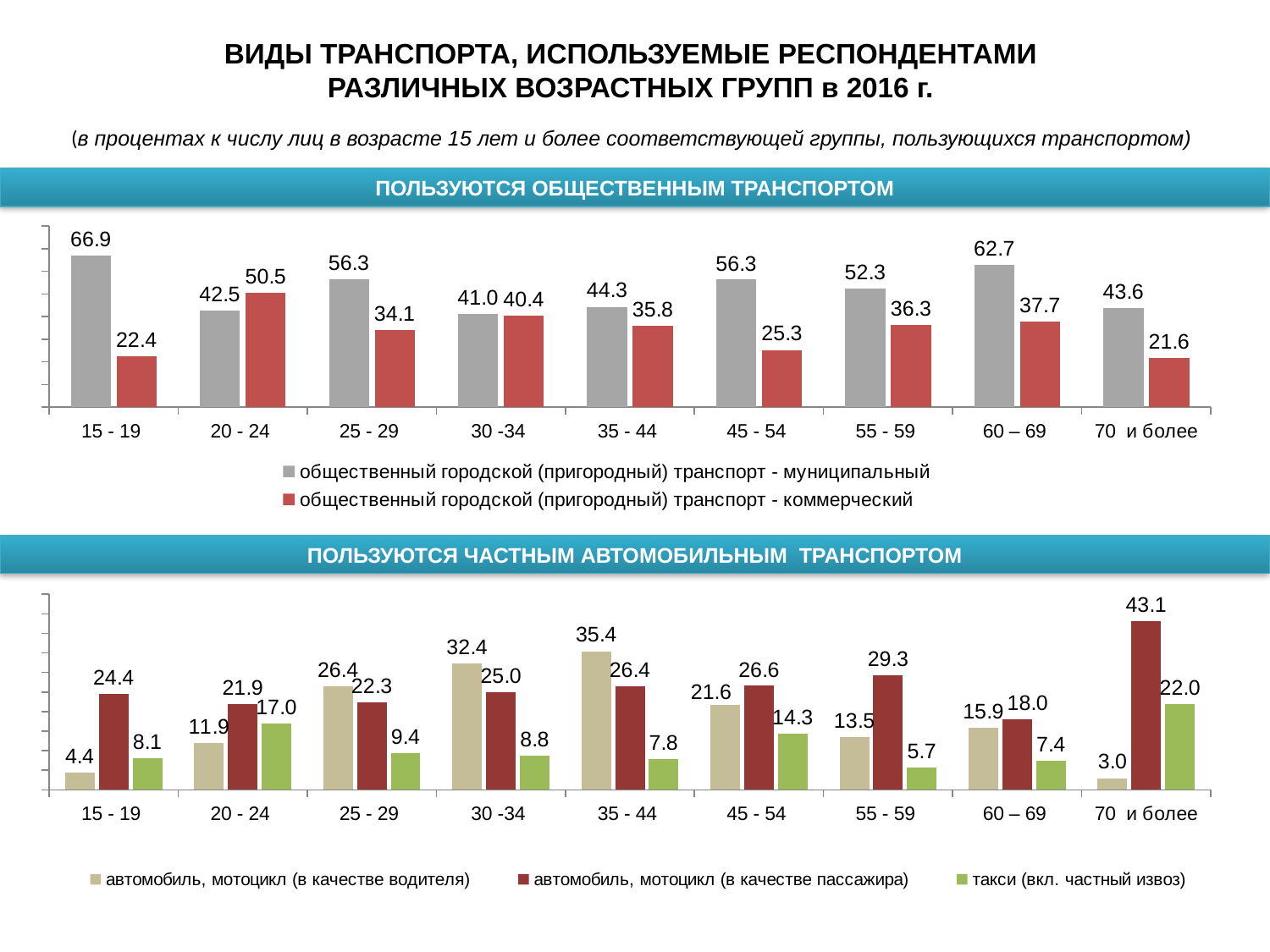
In the chart 'ПОЛЬЗУЮТСЯ ОБЩЕСТВЕННЫМ ТРАНСПОРТОМ', which is larger for the 20 - 24 age group: municipal or commercial public transport? commercial How many age groups are shown on the x axis of the chart 'ПОЛЬЗУЮТСЯ ЧАСТНЫМ АВТОМОБИЛЬНЫМ ТРАНСПОРТОМ'? 9 In the chart 'ПОЛЬЗУЮТСЯ ЧАСТНЫМ АВТОМОБИЛЬНЫМ ТРАНСПОРТОМ', what is the value for taxi in the 70 и более age group? 22.0 In the chart 'ПОЛЬЗУЮТСЯ ОБЩЕСТВЕННЫМ ТРАНСПОРТОМ', which age group has the lowest value for commercial public transport? 70 и более What type of chart is 'ПОЛЬЗУЮТСЯ ЧАСТНЫМ АВТОМОБИЛЬНЫМ ТРАНСПОРТОМ'? bar chart In the chart 'ПОЛЬЗУЮТСЯ ЧАСТНЫМ АВТОМОБИЛЬНЫМ ТРАНСПОРТОМ', which age group has the highest value for car/motorcycle as a driver? 35 - 44 In the chart 'ПОЛЬЗУЮТСЯ ОБЩЕСТВЕННЫМ ТРАНСПОРТОМ', which age group has the highest value for municipal public transport? 15 - 19 In the chart 'ПОЛЬЗУЮТСЯ ОБЩЕСТВЕННЫМ ТРАНСПОРТОМ', what is the value for commercial public transport in the 60 – 69 age group? 37.7 How many series does the legend of the chart 'ПОЛЬЗУЮТСЯ ОБЩЕСТВЕННЫМ ТРАНСПОРТОМ' list? 2 In the chart 'ПОЛЬЗУЮТСЯ ОБЩЕСТВЕННЫМ ТРАНСПОРТОМ', what is the difference between the municipal and commercial values for the 45 - 54 age group? 31.0 In the chart 'ПОЛЬЗУЮТСЯ ОБЩЕСТВЕННЫМ ТРАНСПОРТОМ', what is the value for municipal public transport in the 15 - 19 age group? 66.9 In the chart 'ПОЛЬЗУЮТСЯ ЧАСТНЫМ АВТОМОБИЛЬНЫМ ТРАНСПОРТОМ', which age group has the lowest value for car/motorcycle as a driver? 70 и более